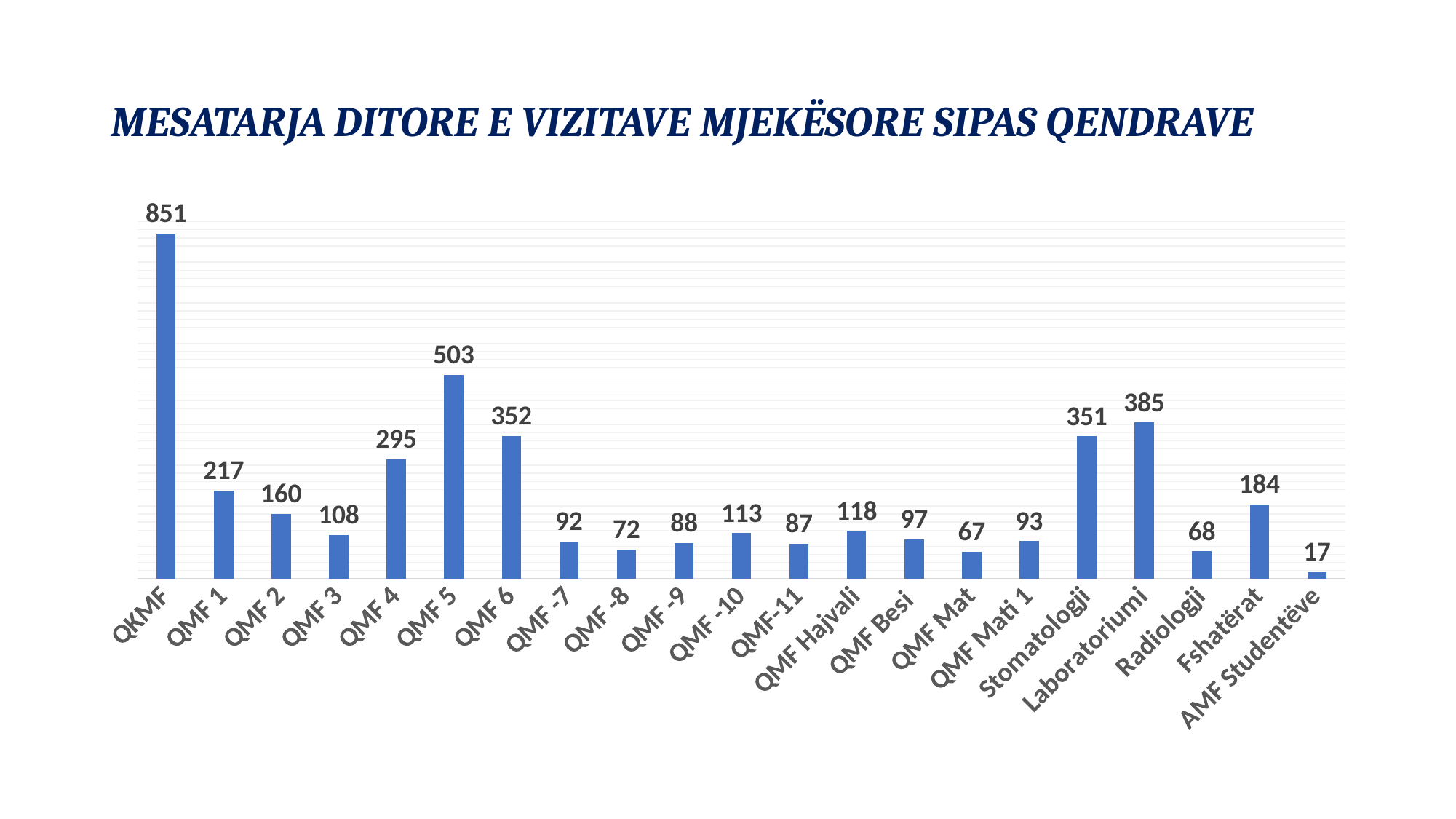
Which is larger, the value for QMF 4 or the value for QMF 1? QMF 4 Which category has the lowest value? AMF Studentëve What is the value for QKMF? 851 What is the title of the chart? MESATARJA DITORE E VIZITAVE MJEKËSORE SIPAS QENDRAVE What is the value for QMF Hajvali? 118 What is the value for QMF 5? 503 What is the value for Laboratoriumi? 385 What kind of chart is shown on the slide? bar chart What is the difference between the values for QMF 5 and QMF 6? 151 What is the difference between the values for Laboratoriumi and Stomatologji? 34 How many categories are shown on the x axis? 21 Which category has the highest value? QKMF